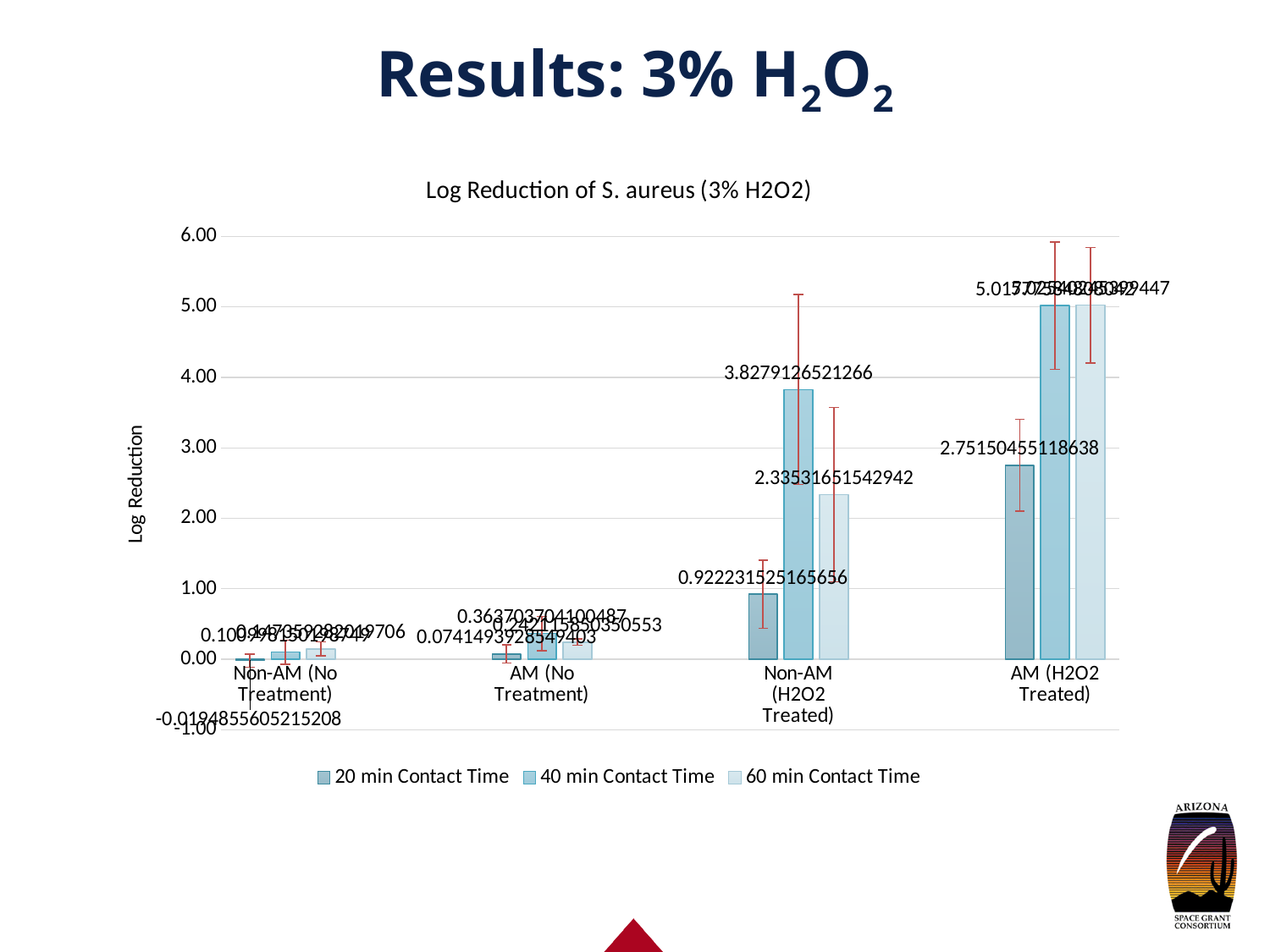
What kind of chart is shown on the slide? Bar chart What is the log reduction for AM (H2O2 Treated) at 20 min Contact Time? 2.75150455118638 What is the log reduction for Non-AM (H2O2 Treated) at 20 min Contact Time? 0.922231525165656 What is the log reduction for Non-AM (H2O2 Treated) at 60 min Contact Time? 2.33531651542942 For Non-AM (H2O2 Treated), which is larger: the 40 min Contact Time value or the 60 min Contact Time value? 40 min Contact Time What is the log reduction for Non-AM (H2O2 Treated) at 40 min Contact Time? 3.8279126521266 What is the difference between the 40 min and 60 min Contact Time values for Non-AM (H2O2 Treated)? 1.49259613669718 How many series does the legend list? 3 How many categories are shown on the x axis? 4 Which category has the highest 40 min Contact Time bar? AM (H2O2 Treated) What is the log reduction for Non-AM (No Treatment) at 20 min Contact Time? -0.0194855605215208 Is the 40 min Contact Time value for AM (H2O2 Treated) greater or less than 4.00? greater